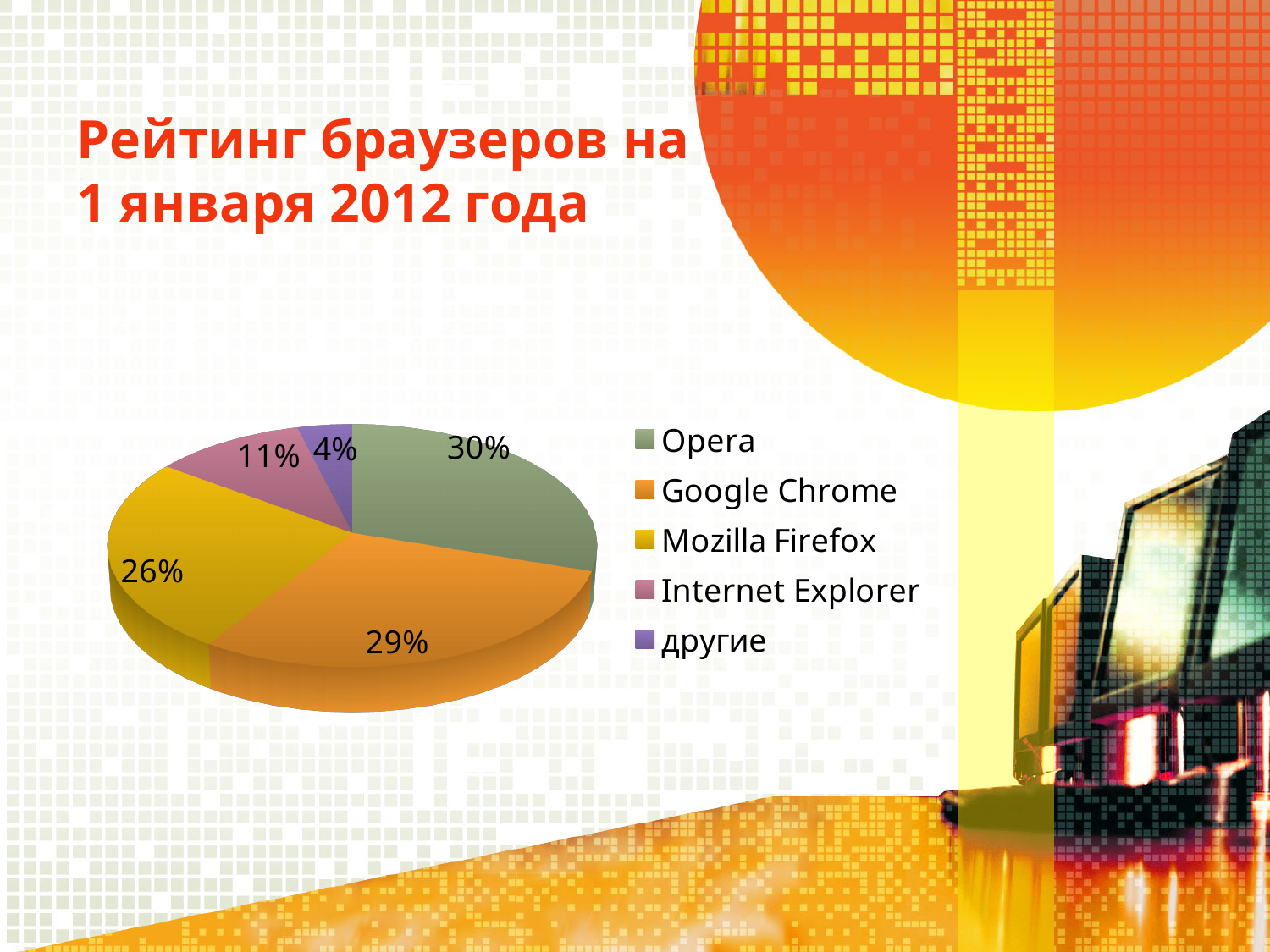
What share of the pie does Mozilla Firefox have? 26% What share of the pie does Opera have? 30% Which category has the smallest slice of the pie? другие What is the title of the slide containing the chart? Рейтинг браузеров на 1 января 2012 года What share of the pie does Google Chrome have? 29% What share of the pie does Internet Explorer have? 11% What kind of chart is shown on the slide? Pie chart What share of the pie does the category 'другие' have? 4% How many categories are shown in the pie chart? 5 Which browser has the largest slice of the pie? Opera Which has a larger share, Mozilla Firefox or Internet Explorer? Mozilla Firefox What is the difference between the shares of Opera and Internet Explorer? 19%